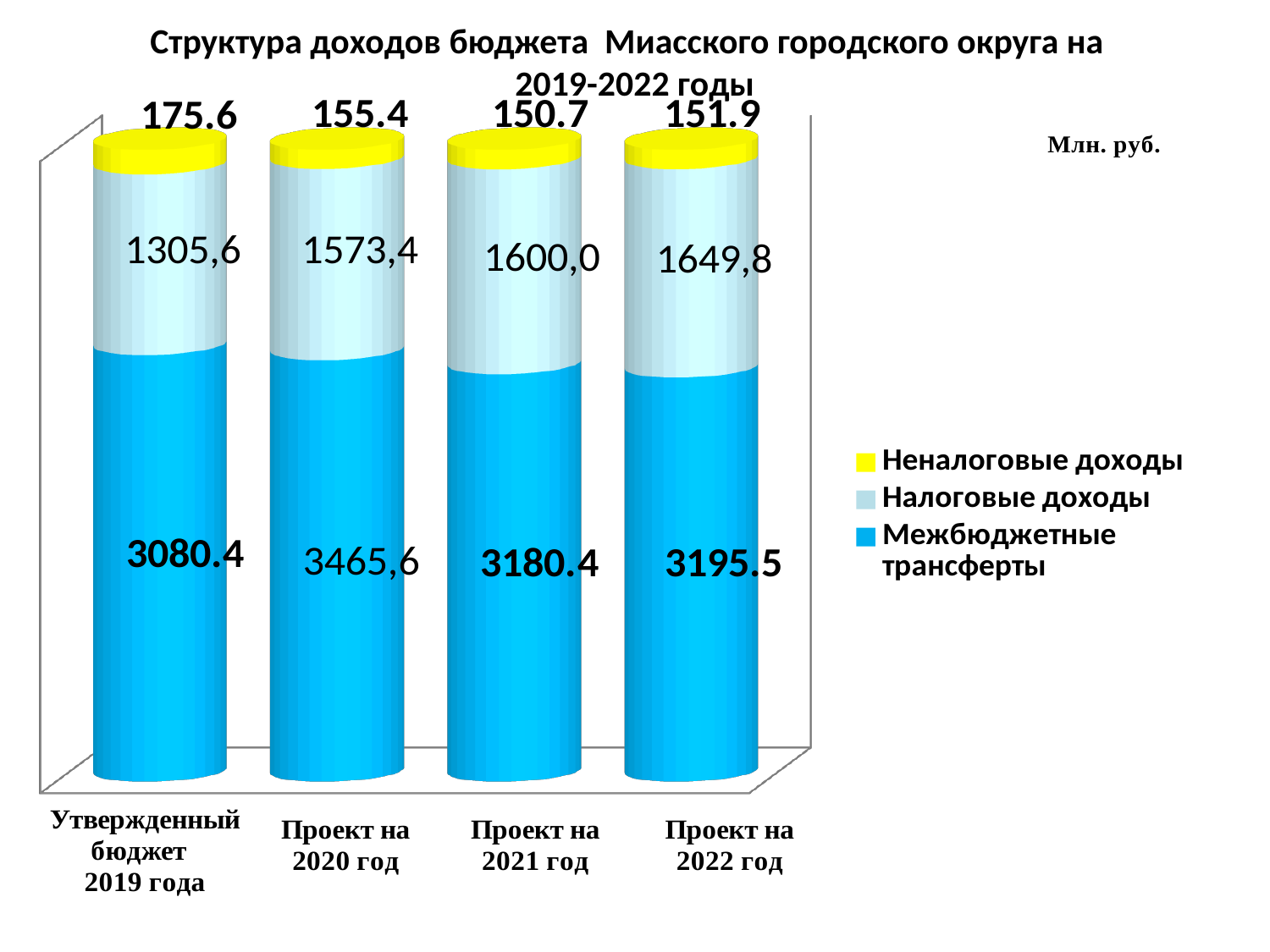
Which is larger: Неналоговые доходы for Утвержденный бюджет 2019 года or for Проект на 2020 год? Утвержденный бюджет 2019 года What kind of chart is shown on the slide? Stacked bar chart Do the values for Налоговые доходы rise or fall from 2019 to 2022? Rise What is the value of Межбюджетные трансферты for Утвержденный бюджет 2019 года? 3080.4 What is the difference between Налоговые доходы for Проект на 2022 год and for Утвержденный бюджет 2019 года? 344,2 How many categories are shown on the x axis? 4 Which category has the lowest value for Налоговые доходы? Утвержденный бюджет 2019 года What is the value of Налоговые доходы for Проект на 2021 год? 1600,0 What is the value of Неналоговые доходы for Проект на 2022 год? 151.9 What is the total of the stacked bar for Проект на 2020 год? 5194,4 Which category has the highest value for Межбюджетные трансферты? Проект на 2020 год How many series does the legend list? 3